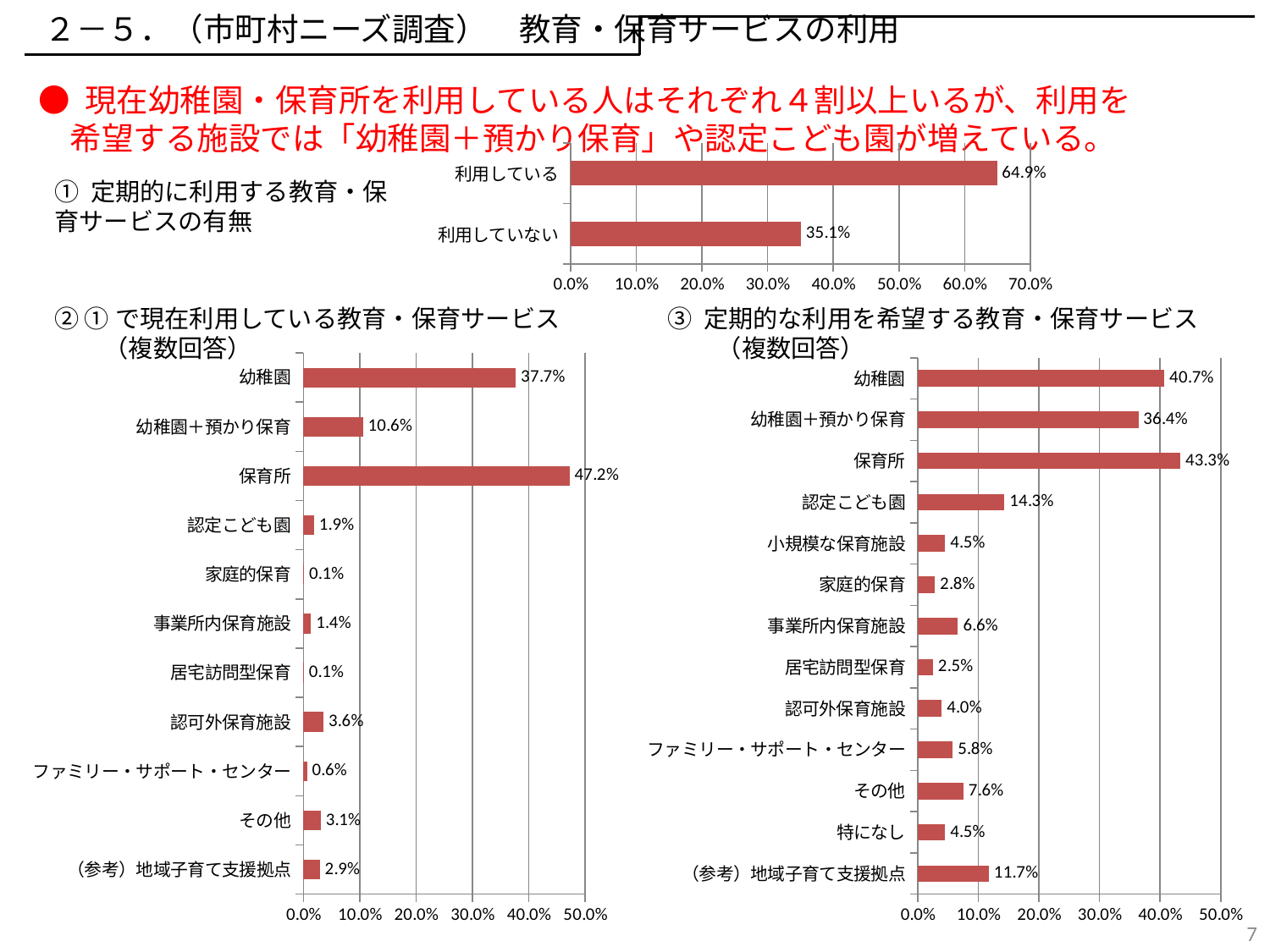
What kind of chart is chart ① (定期的に利用する教育・保育サービスの有無)? Bar chart In chart ① (定期的に利用する教育・保育サービスの有無), what is the value for 利用している? 64.9% In chart ③ (定期的な利用を希望する教育・保育サービス), which is larger, 幼稚園 or 幼稚園＋預かり保育? 幼稚園 In chart ② (①で現在利用している教育・保育サービス), what is the value for 幼稚園＋預かり保育? 10.6% In chart ③ (定期的な利用を希望する教育・保育サービス), how many categories are plotted? 13 In chart ③ (定期的な利用を希望する教育・保育サービス), what is the value for 認定こども園? 14.3% In chart ② (①で現在利用している教育・保育サービス), which category has the highest value? 保育所 In chart ① (定期的に利用する教育・保育サービスの有無), what is the difference between 利用している and 利用していない? 29.8% In chart ② (①で現在利用している教育・保育サービス), what is the value for 認可外保育施設? 3.6% In chart ③ (定期的な利用を希望する教育・保育サービス), which category has the lowest value? 居宅訪問型保育 In chart ③ (定期的な利用を希望する教育・保育サービス), which category has the highest value? 保育所 In chart ② (①で現在利用している教育・保育サービス), how many categories are plotted? 11